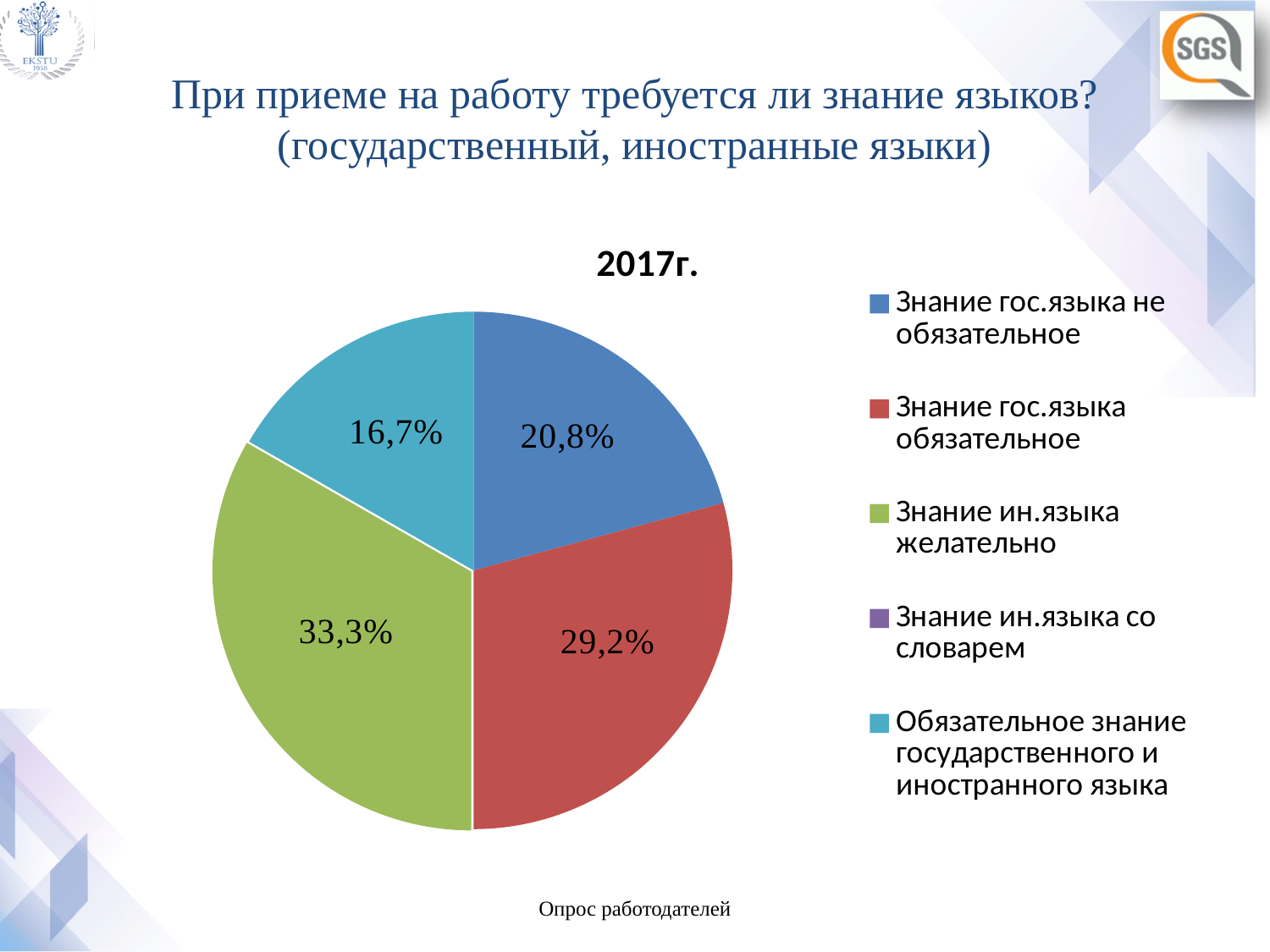
What is the difference between the shares for "Знание ин.языка желательно" and "Знание гос.языка обязательное"? 4,1% What kind of chart is shown on the slide? pie chart Which category has the largest slice of the pie? Знание ин.языка желательно What is the title of the chart? 2017г. What share of the pie is labelled for "Знание гос.языка не обязательное"? 20,8% Which of the visible slices is the smallest? Обязательное знание государственного и иностранного языка What share of the pie is labelled for "Знание ин.языка желательно"? 33,3% What share of the pie is labelled for "Обязательное знание государственного и иностранного языка"? 16,7% Which is larger: the share for "Знание гос.языка не обязательное" or for "Обязательное знание государственного и иностранного языка"? Знание гос.языка не обязательное How many entries does the legend list? 5 How many slices are visible in the pie? 4 What share of the pie is labelled for "Знание гос.языка обязательное"? 29,2%